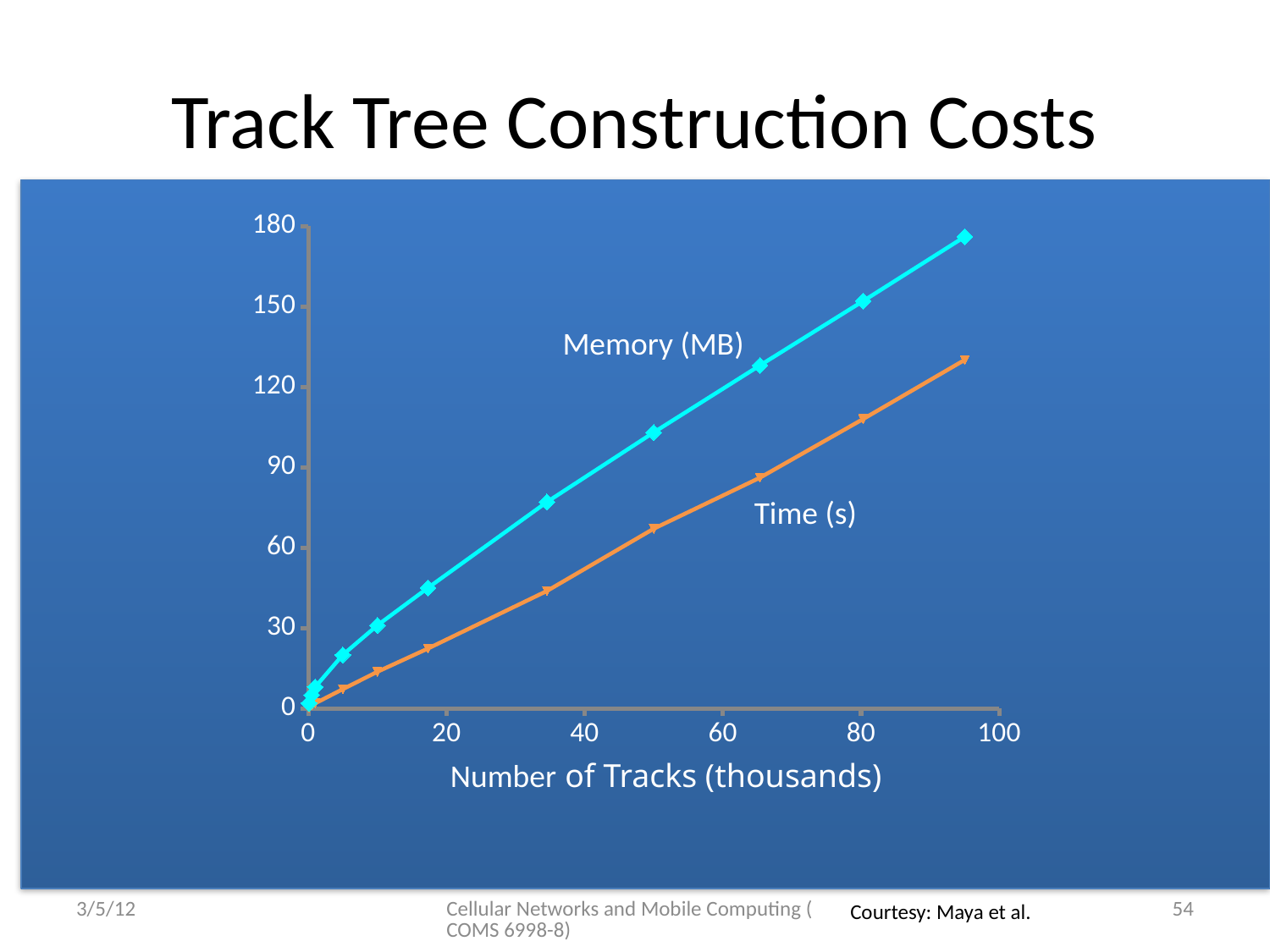
What is the title of the chart on the slide? Track Tree Construction Costs Is the Time (s) value at the rightmost point (about 95 thousand tracks) greater or less than 150? less Does the Time (s) series rise or fall as the number of tracks increases? rise At 80 thousand tracks, which is larger, the Memory (MB) value or the Time (s) value? Memory (MB) What kind of chart is shown on the slide? line chart Is the Time (s) value at 80 thousand tracks greater or less than 90? greater Does the Memory (MB) series rise or fall as the number of tracks increases? rise Is the Memory (MB) value at 35 thousand tracks greater or less than 90? less What is the label of the x axis? Number of Tracks (thousands) Which series reaches the higher value at the right end of the chart, Memory (MB) or Time (s)? Memory (MB) How many series are plotted on the chart? 2